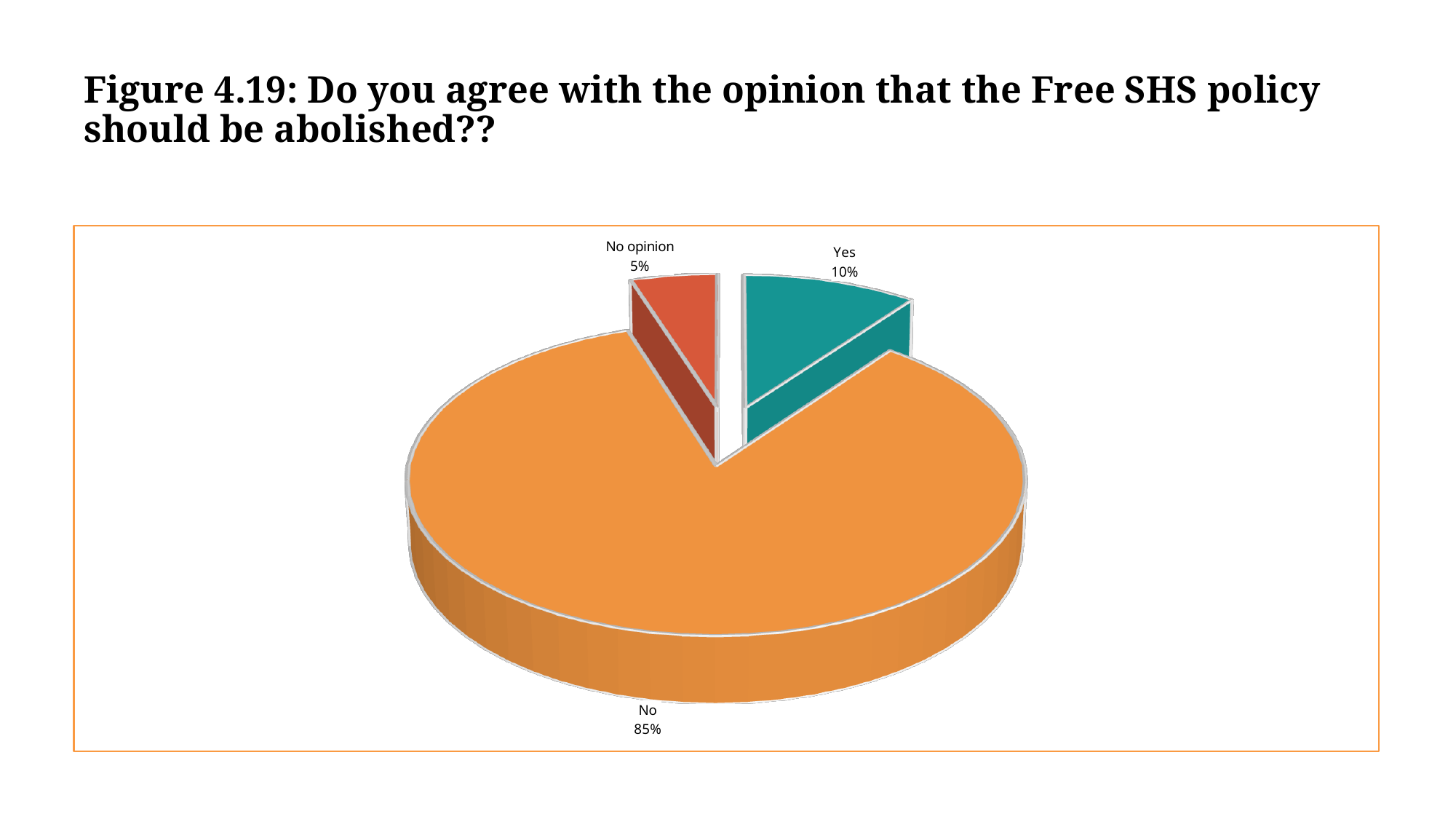
Which response has the smallest share of the pie? No opinion What percentage of respondents answered "Yes"? 10% What is the difference in percentage points between the "No" and "Yes" slices? 75 What colour is the "No" slice? Orange What percentage of respondents had "No opinion"? 5% What is the difference in percentage points between the "Yes" and "No opinion" slices? 5 What kind of chart is shown on the slide? Pie chart What is the figure number given in the chart title? Figure 4.19 Which is larger, the "Yes" slice or the "No opinion" slice? Yes How many slices does the pie chart have? 3 What percentage of respondents answered "No"? 85% Which response has the largest share of the pie? No